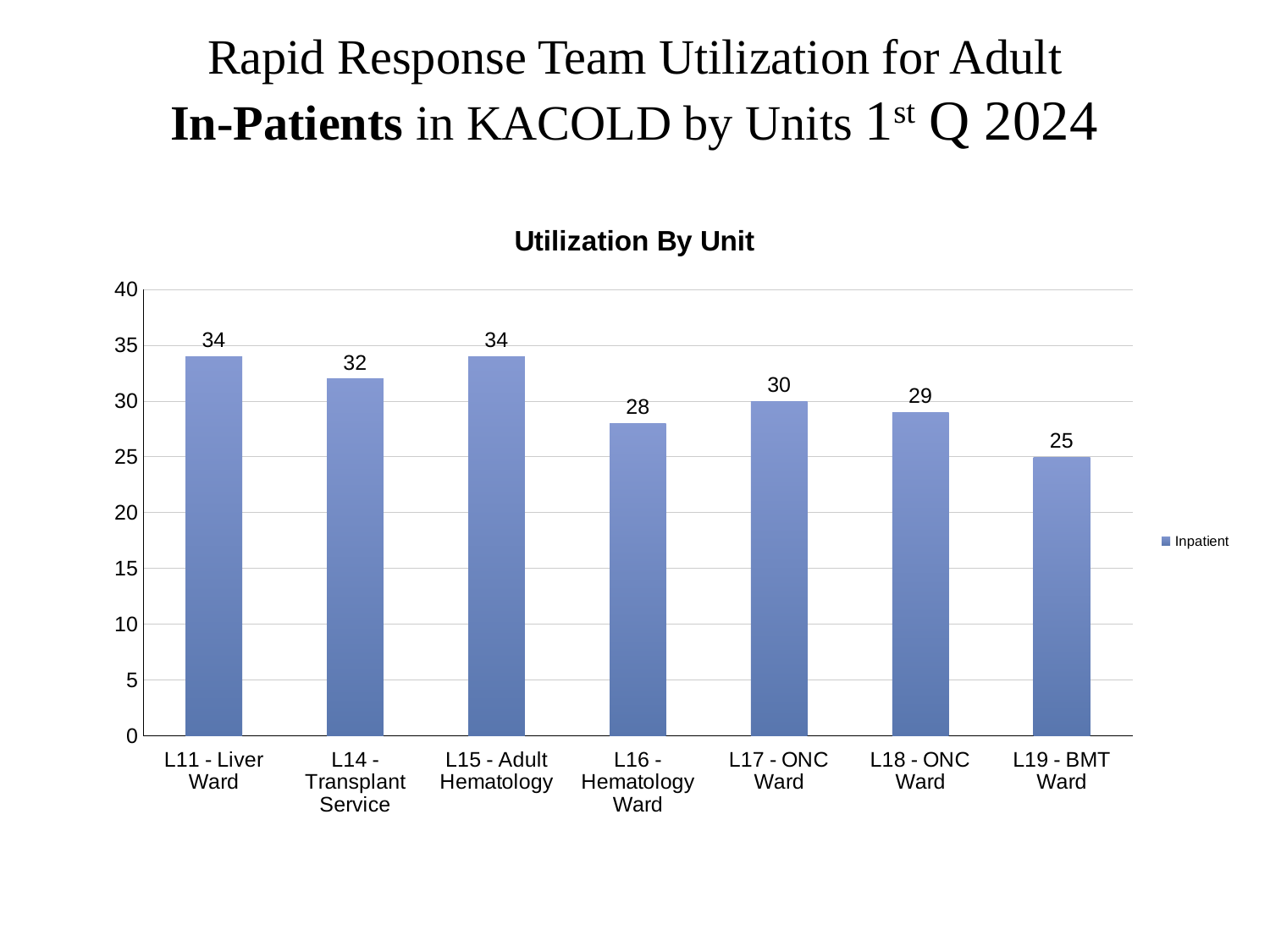
Which unit has the lowest value? L19 - BMT Ward What kind of chart is shown? bar chart Which is larger, the value for L14 - Transplant Service or the value for L17 - ONC Ward? L14 - Transplant Service Is the value for L19 - BMT Ward greater or less than 30? less How many units are shown on the x axis? 7 What is the difference between the values for L17 - ONC Ward and L16 - Hematology Ward? 2 What is the difference between the values for L11 - Liver Ward and L19 - BMT Ward? 9 What is the value for L18 - ONC Ward? 29 What is the value for L14 - Transplant Service? 32 How many series does the legend list? 1 What is the title of the chart? Utilization By Unit What is the value for L16 - Hematology Ward? 28